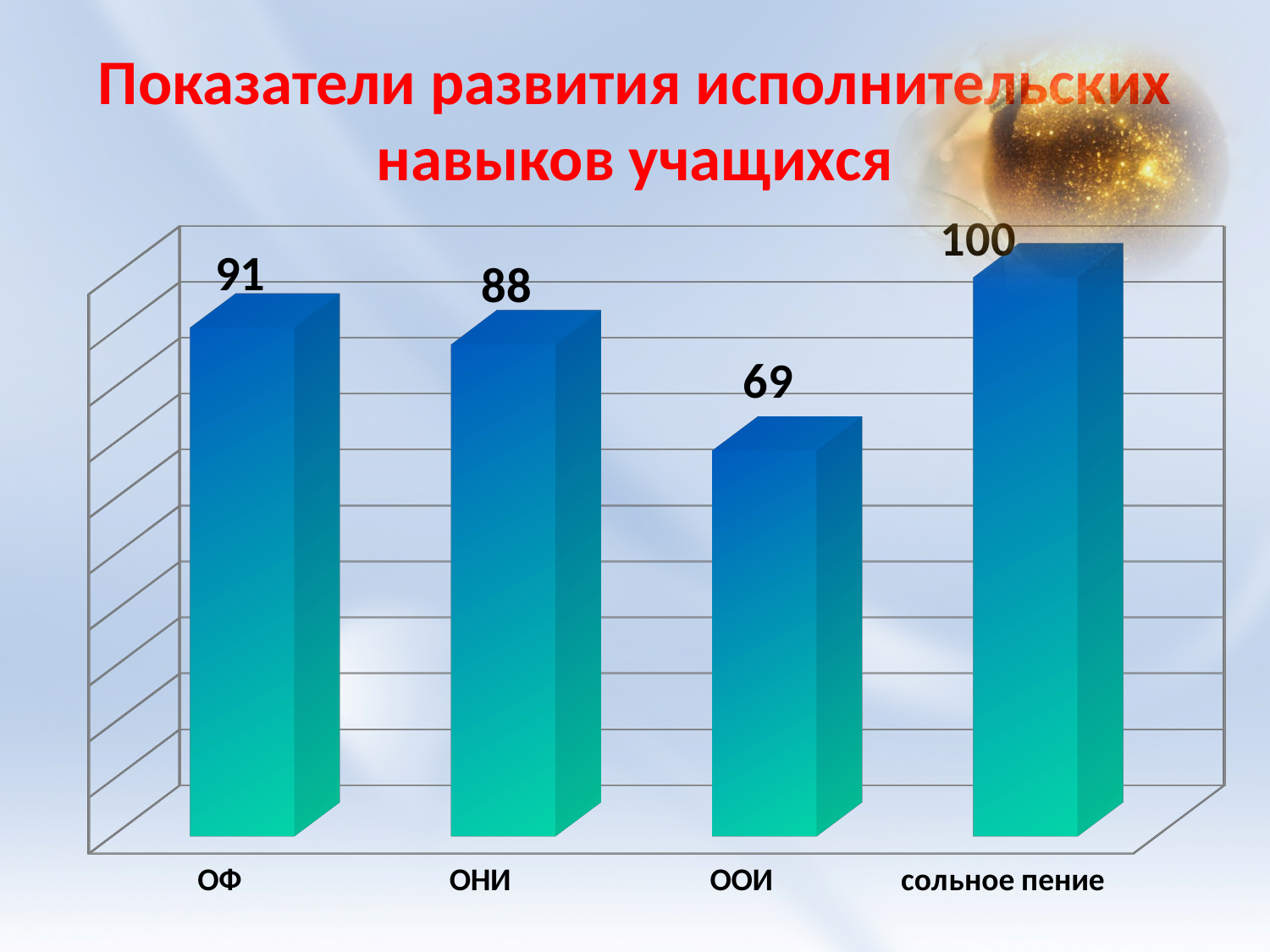
Which category has the lowest value? ООИ What is the difference between the values for сольное пение and ООИ? 31 What is the value for ООИ? 69 How many categories are shown in the chart? 4 What is the title of the slide? Показатели развития исполнительских навыков учащихся Which is larger, the value for ОФ or the value for ООИ? ОФ What kind of chart is shown on the slide? bar chart Which category has the highest value? сольное пение What is the value for ОФ? 91 What is the value for сольное пение? 100 What is the difference between the values for ОФ and ОНИ? 3 What is the value for ОНИ? 88